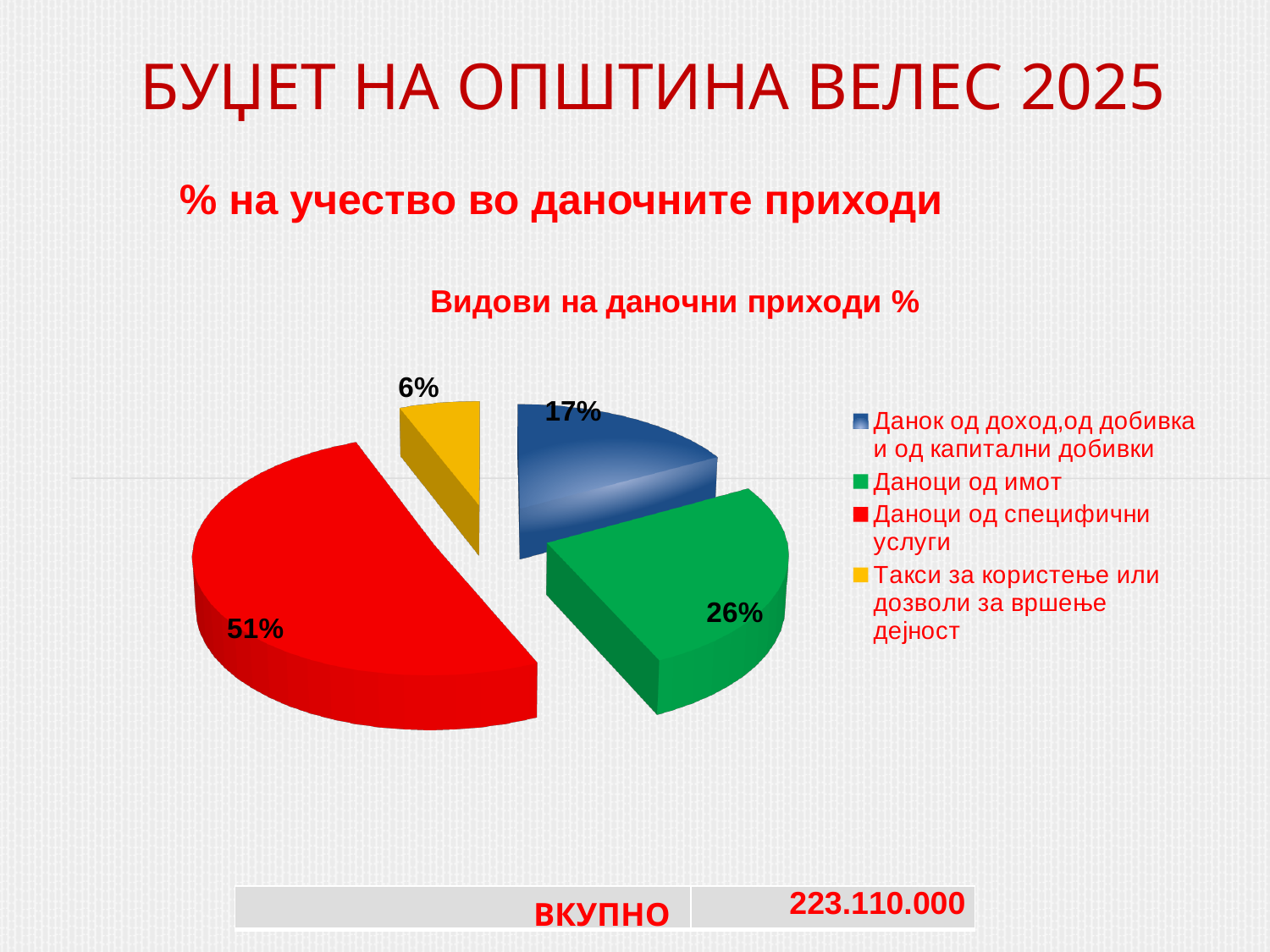
Which category has the largest share of the pie? Даноци од специфични услуги What share of the pie does 'Даноци од специфични услуги' have? 51% What is the title of the chart? Видови на даночни приходи % Which is larger: the share for 'Даноци од имот' or the share for 'Данок од доход,од добивка и од капитални добивки'? Даноци од имот How many categories does the pie chart show? 4 Which category has the smallest share of the pie? Такси за користење или дозволи за вршење дејност What share of the pie does 'Даноци од имот' have? 26% What is the difference in percentage points between 'Даноци од специфични услуги' and 'Даноци од имот'? 25 Which colour represents 'Даноци од имот' in the chart? Green What share of the pie does 'Данок од доход,од добивка и од капитални добивки' have? 17% What kind of chart is shown on the slide? Pie chart